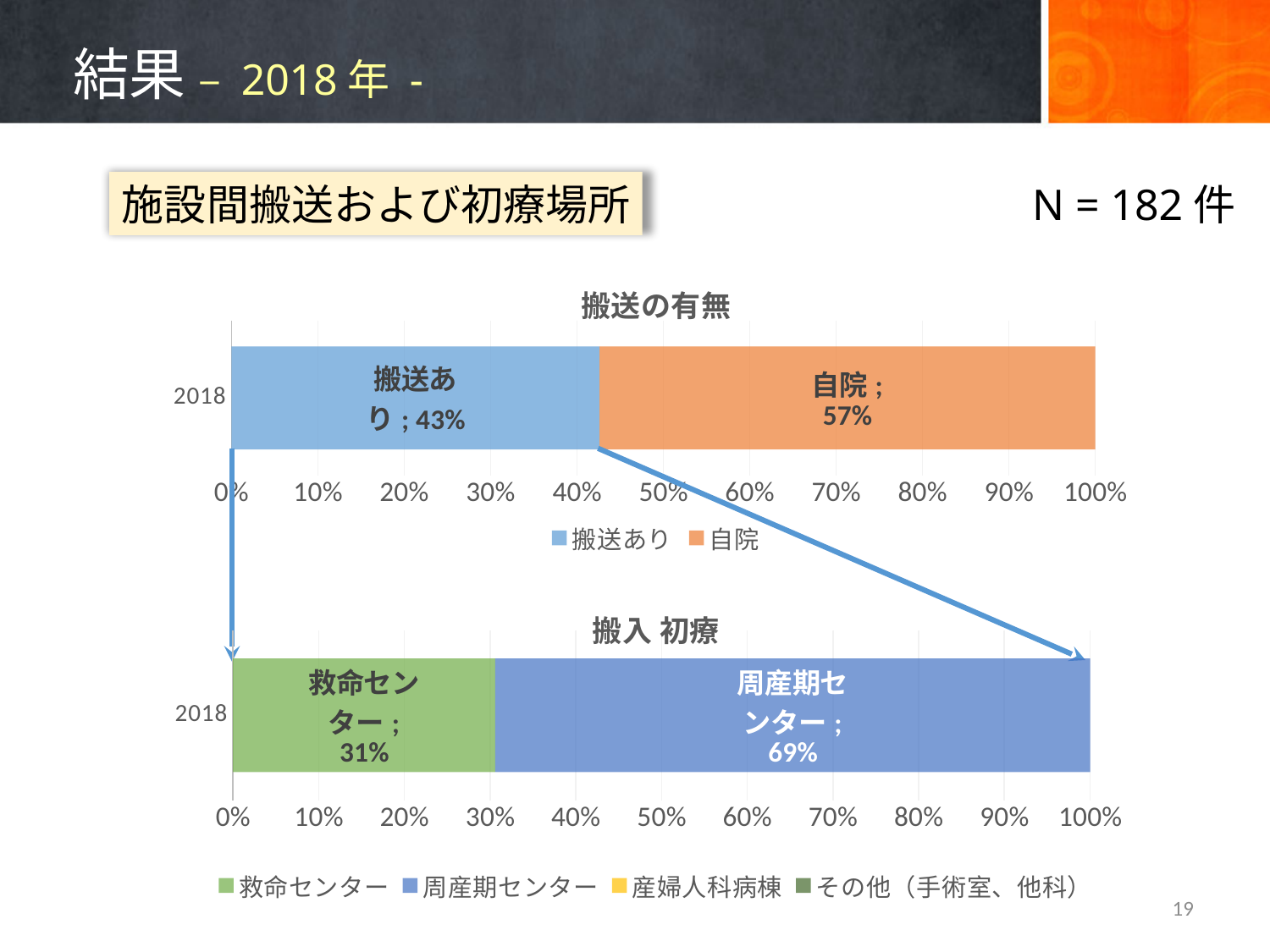
In the 搬入 初療 chart, how many series does the legend list? 4 What kind of chart is the 搬入 初療 chart? Stacked bar chart In the 搬送の有無 chart, which segment is larger, 搬送あり or 自院? 自院 In the 搬入 初療 chart, what is the difference between the 周産期センター and 救命センター values? 38% In the 搬送の有無 chart, how many series does the legend list? 2 In the 搬送の有無 chart, what is the difference between the 自院 and 搬送あり values? 14% In the 搬入 初療 chart, what is the value for 周産期センター? 69% In the 搬入 初療 chart, what is the value for 救命センター? 31% In the 搬送の有無 chart, what is the value for 搬送あり? 43% In the 搬送の有無 chart, what is the value for 自院? 57% In the 搬入 初療 chart, which segment is the largest? 周産期センター In the 搬入 初療 chart, is the value for 救命センター greater or less than 40%? less